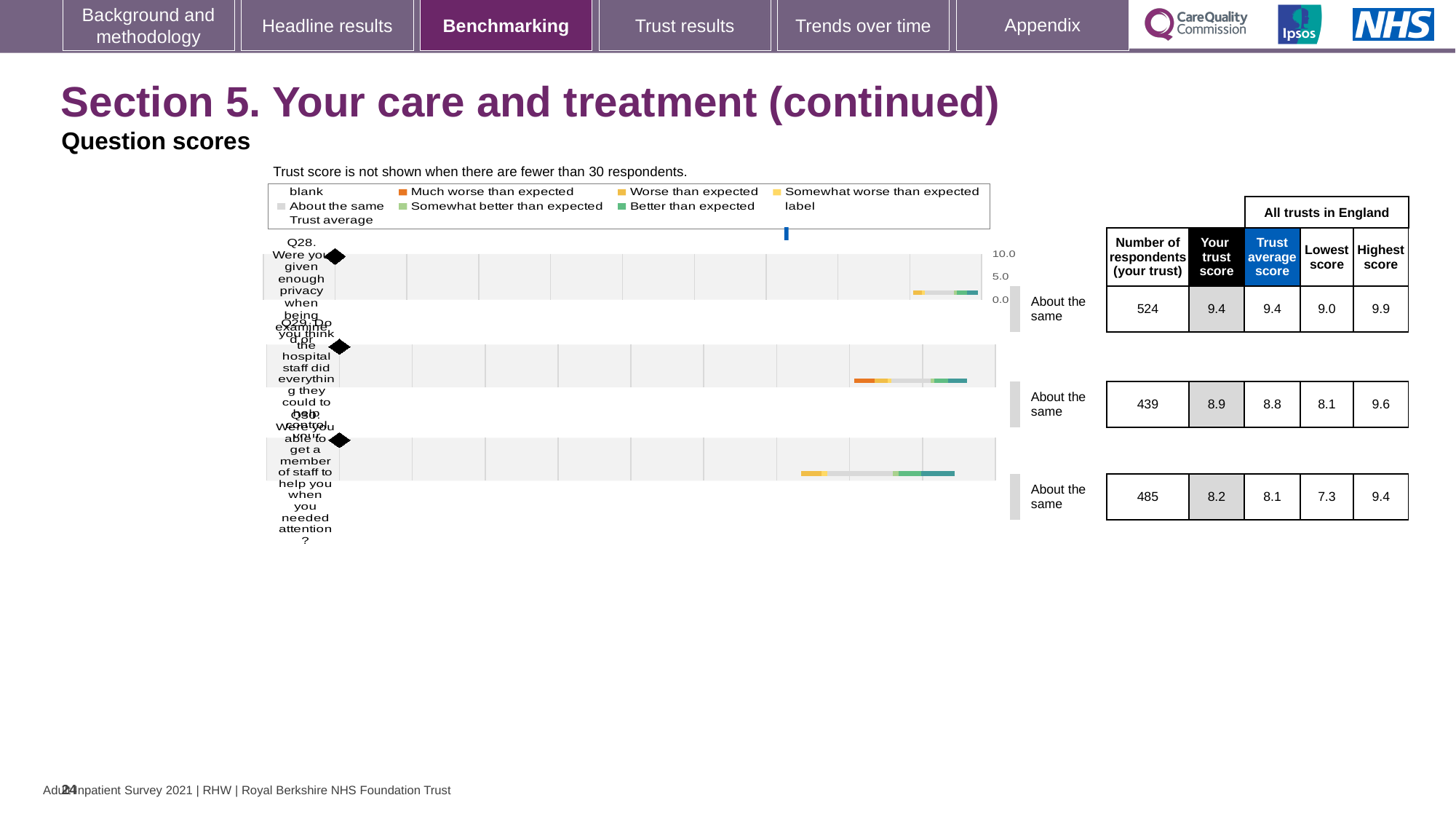
What is the trust score for Q28 (Were you given enough privacy when being examined or treated?)? 9.4 Is the trust score for Q29 higher or lower than the trust average score for Q29? higher What kind of chart is used to show the question scores? bar chart Which of the three questions shown has the highest trust score? Q28 Which of the three questions shown has the lowest trust score? Q30 What is the trust average score for Q29 (Do you think the hospital staff did everything they could to help control your pain?)? 8.8 How many questions are plotted on this slide? 3 How many respondents answered Q29 at this trust? 439 What is the highest score across all trusts in England for Q30? 9.4 What is the trust score for Q30 (Were you able to get a member of staff to help you when you needed attention?)? 8.2 What is the difference between the trust score for Q28 and the trust score for Q30? 1.2 What benchmark category is shown next to each of the three questions? About the same